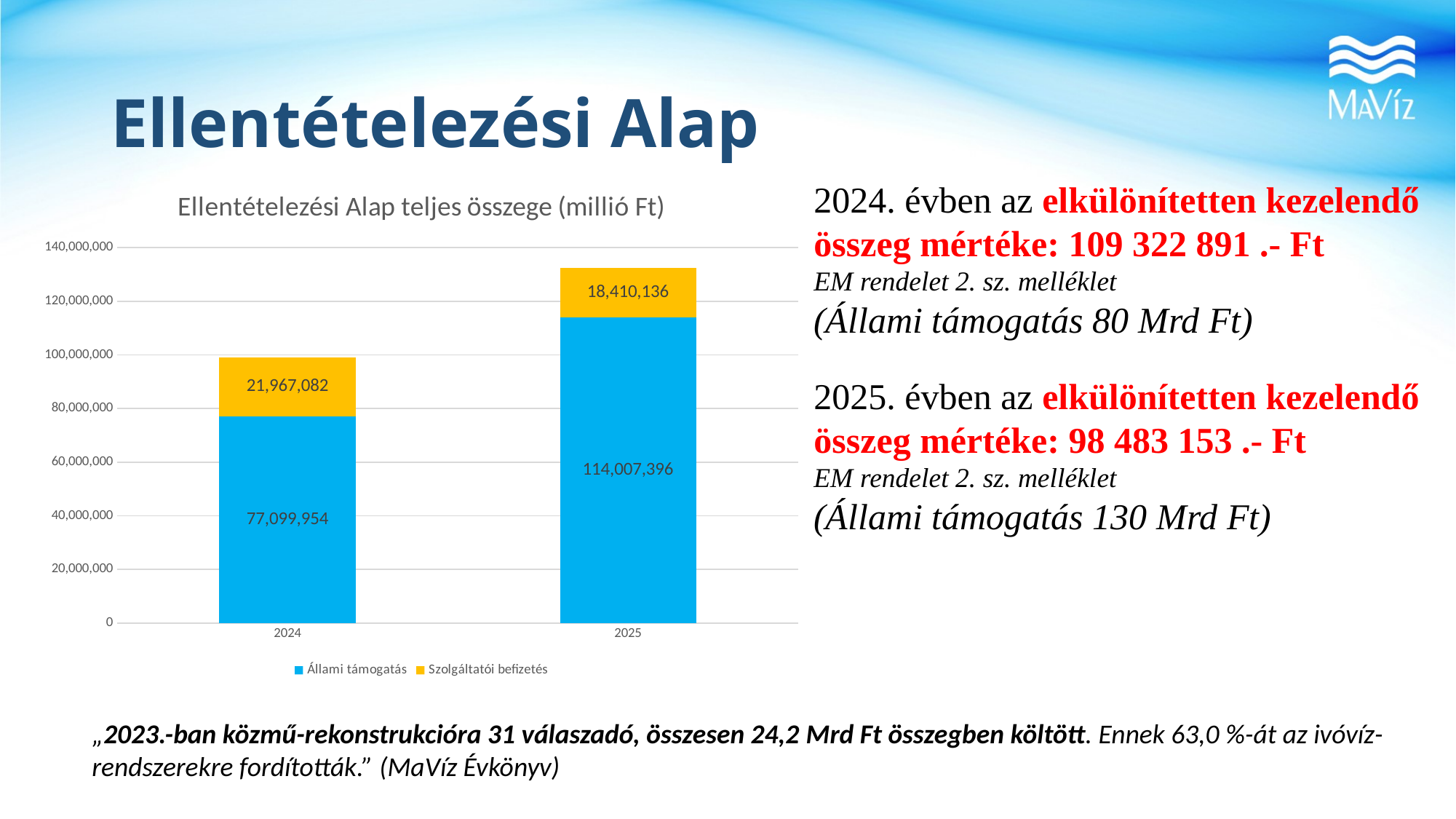
What is the value of Szolgáltatói befizetés for 2024? 21,967,082 What is the value of Állami támogatás for 2025? 114,007,396 What is the title of the chart? Ellentételezési Alap teljes összege (millió Ft) What is the difference between the Állami támogatás values for 2025 and 2024? 36,907,442 What is the value of Állami támogatás for 2024? 77,099,954 How many series does the legend list? 2 Which year has the larger Szolgáltatói befizetés value, 2024 or 2025? 2024 What is the total of the stacked bar for 2024? 99,067,036 Is the total of the 2025 bar greater or less than 120,000,000? greater What is the total of the stacked bar for 2025? 132,417,532 What kind of chart is shown on the slide? Stacked bar chart What is the value of Szolgáltatói befizetés for 2025? 18,410,136